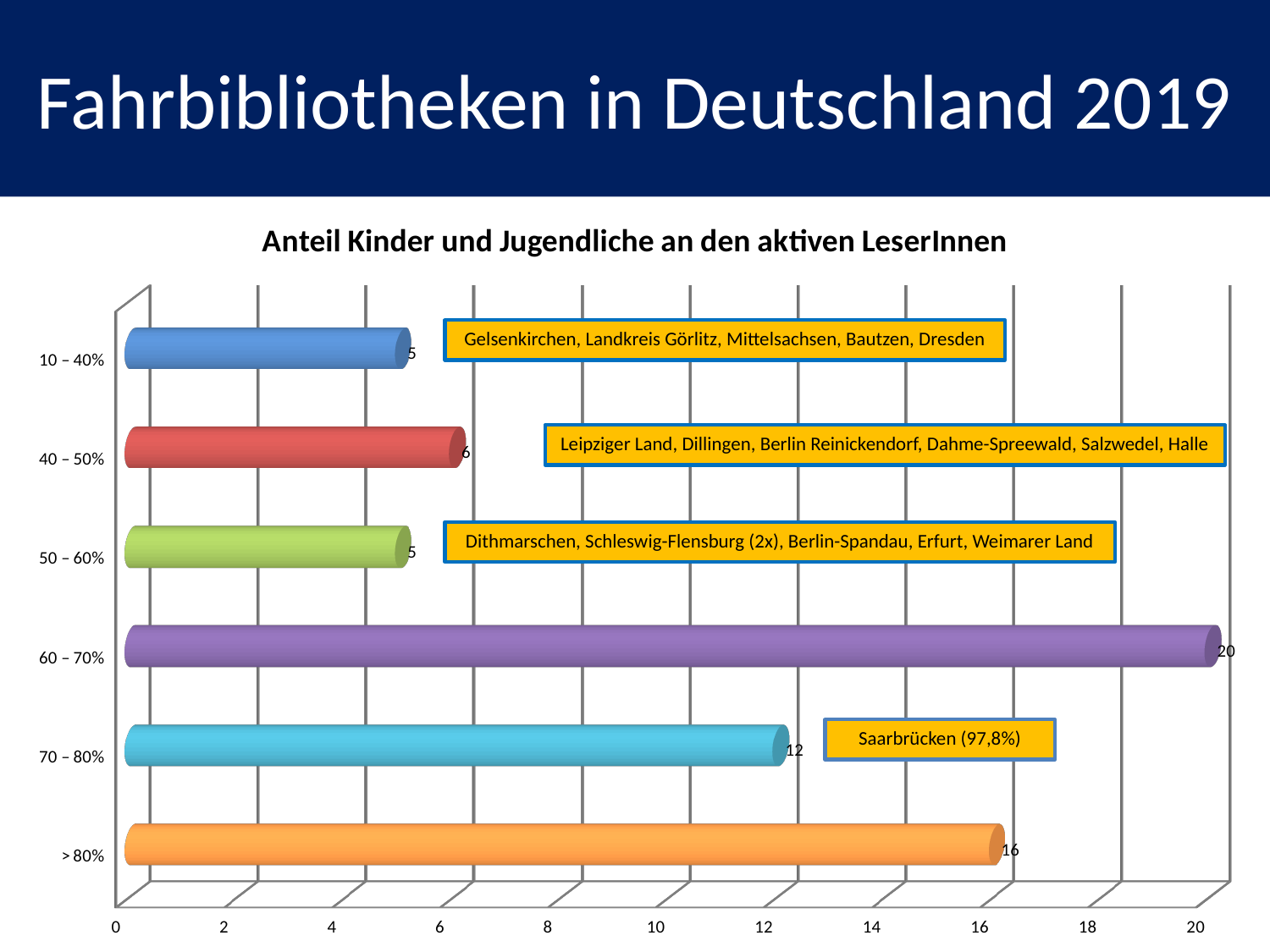
What is the difference between the values for 60 – 70% and 70 – 80%? 8 Which category has the highest value? 60 – 70% What is the value for the 40 – 50% category? 6 What kind of chart is shown on the slide? bar chart What is the value for the > 80% category? 16 How many categories are shown on the chart? 6 Is the value for 60 – 70% greater or less than 18? greater Which library is named in the label next to the 70 – 80% bar? Saarbrücken (97,8%) What is the title of the chart? Anteil Kinder und Jugendliche an den aktiven LeserInnen Which is larger, the value for > 80% or the value for 70 – 80%? > 80% What is the value for the 70 – 80% category? 12 What is the value for the 60 – 70% category? 20